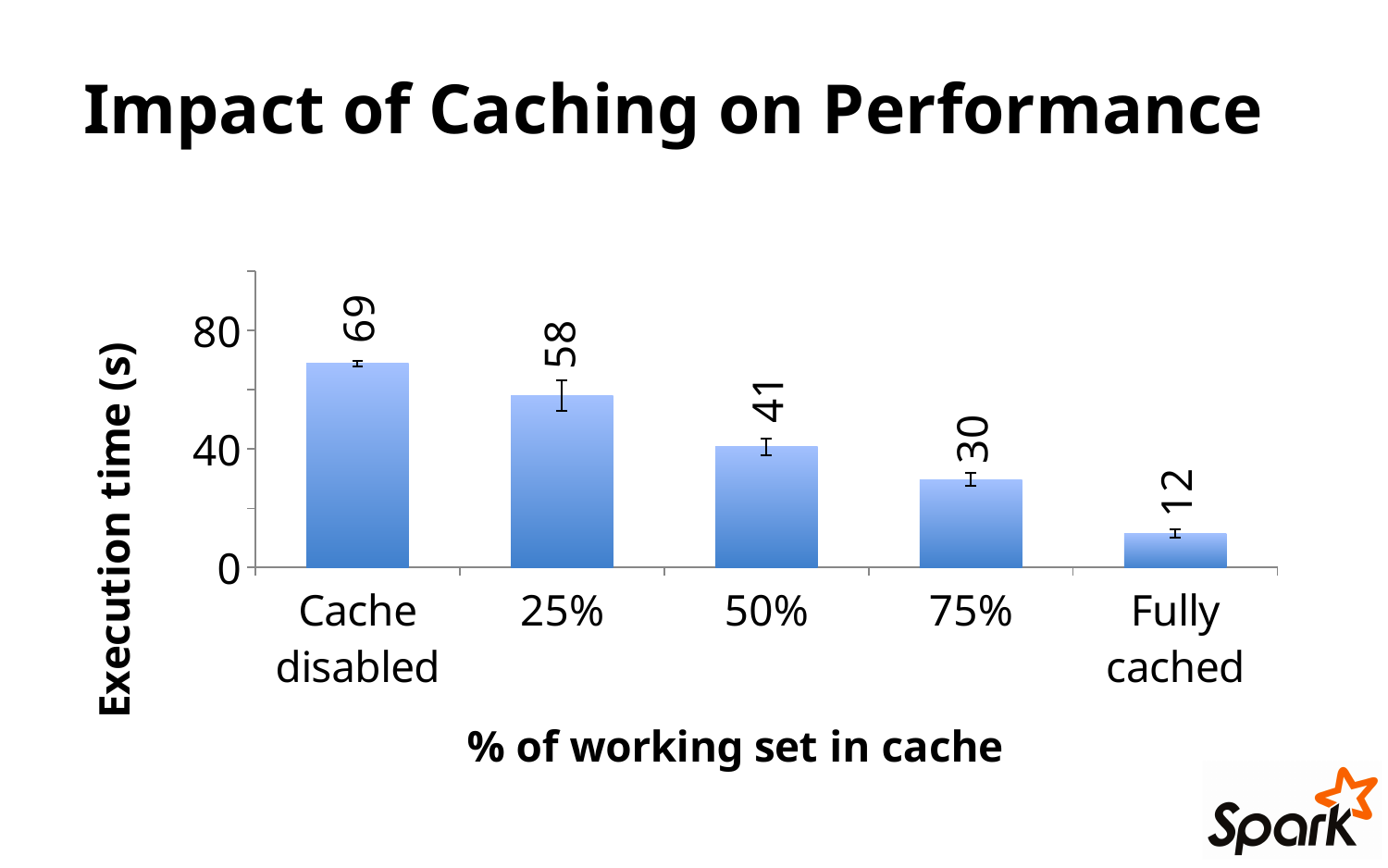
What is the execution time when the working set is fully cached? 12 Which category has the highest execution time? Cache disabled What is the execution time with 50% of the working set in cache? 41 What kind of chart is shown on the slide? Bar chart How many categories are shown on the x axis? 5 Is the execution time for 75% of the working set in cache greater or less than 40? less Which category has the lowest execution time? Fully cached What is the execution time when the cache is disabled? 69 Which has a larger execution time, 25% or 75% of the working set in cache? 25% What is the difference in execution time between Cache disabled and Fully cached? 57 Does execution time rise or fall as the percentage of the working set in cache increases? Fall What is the difference in execution time between 25% and 75% of the working set in cache? 28